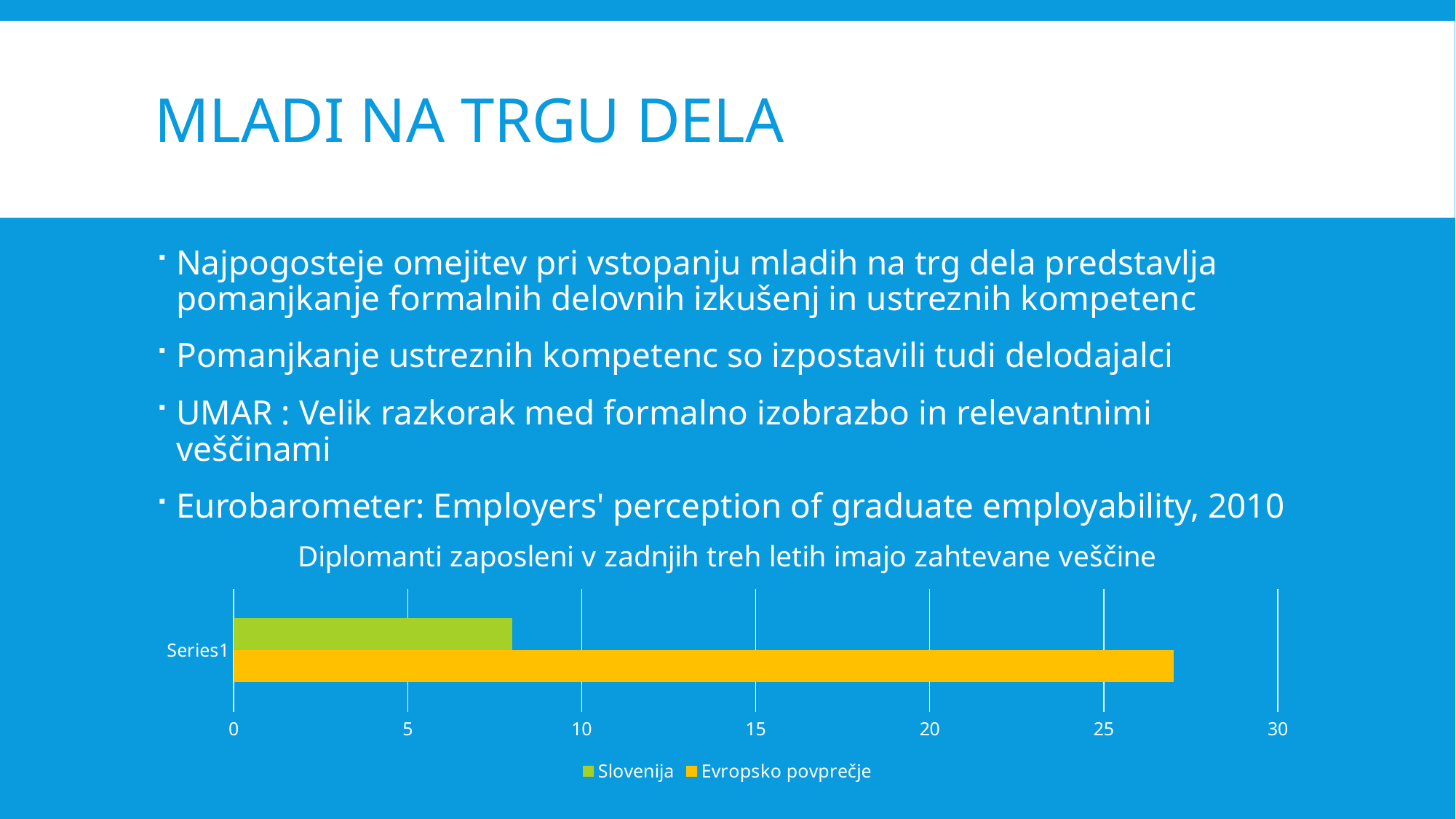
Which series has the highest value on the chart? Evropsko povprečje Is the value for Evropsko povprečje greater or less than 25? greater How many categories are plotted on the chart's vertical axis? 1 Which series has the shortest bar on the chart? Slovenija Which colour represents Slovenija in the chart legend? green Is the value for Slovenija greater or less than 5? greater Is the value for Slovenija greater or less than 10? less What kind of chart is shown on the slide? bar chart How many series does the chart legend list? 2 What is the title of the chart? Diplomanti zaposleni v zadnjih treh letih imajo zahtevane veščine Which series has the longer bar, Slovenija or Evropsko povprečje? Evropsko povprečje